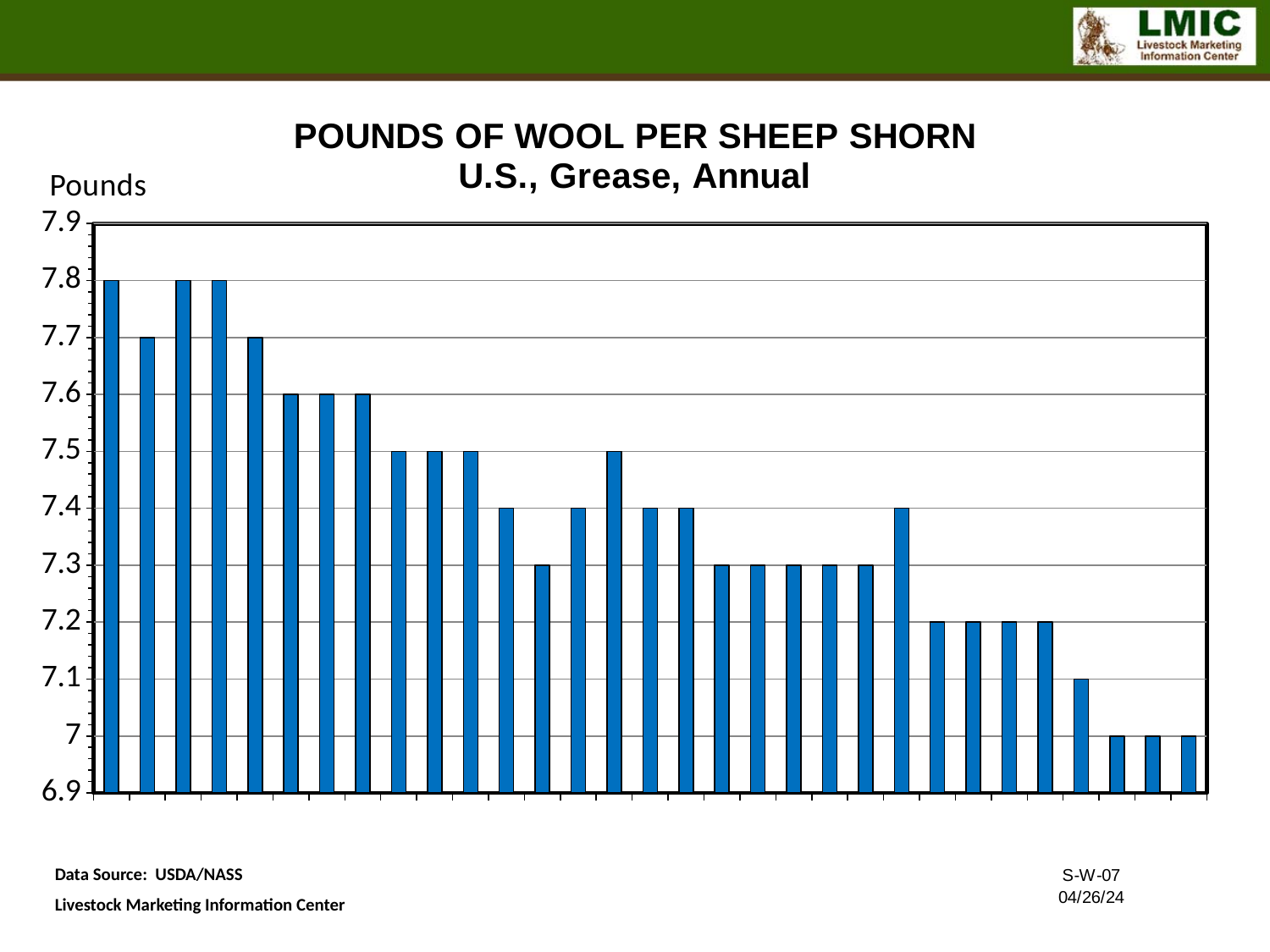
What is the highest value reached by any bar in the chart? 7.8 What is the lowest value reached by any bar in the chart? 7 Is the value of the leftmost bar greater or less than 7.5? greater What is the title of the chart? POUNDS OF WOOL PER SHEEP SHORN U.S., Grease, Annual What kind of chart is shown on the slide? bar chart Which is larger, the value of the first bar or the value of the last bar? the first bar What is the difference between the value of the first bar and the value of the last bar? 0.8 What is the value of the first (leftmost) bar in the chart? 7.8 What unit is shown on the vertical axis label of the chart? Pounds Is the value of the rightmost bar greater or less than 7.2? less What is the value of the last (rightmost) bar in the chart? 7 Do the values generally rise or fall from left to right across the chart? fall